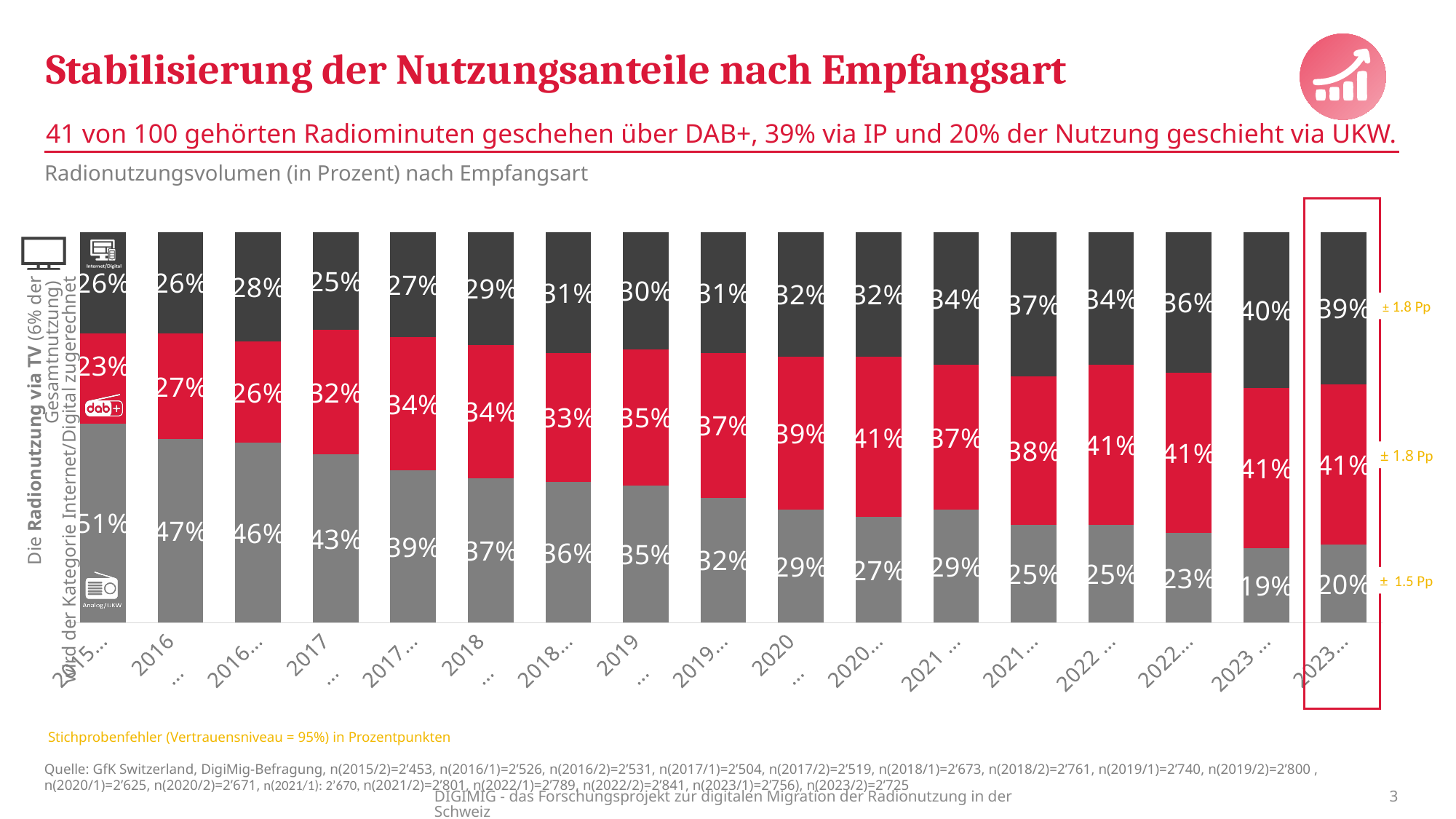
In the last, highlighted bar (2023), what percentage is shown for the dark top segment (Internet/Digital)? 39% In the last, highlighted bar, which segment is larger: the red DAB+ segment or the dark Internet/Digital segment? The red DAB+ segment (41%) How many bars (survey waves) are plotted in the chart? 17 What is the lowest value shown for the grey bottom segment (Analog/UKW) across all bars? 19% In the first bar (2015), what percentage is shown for the grey bottom segment (Analog/UKW)? 51% By how many percentage points does the grey segment (Analog/UKW) differ between the first bar (51%) and the last bar (20%)? 31 percentage points In the last, highlighted bar (2023), what percentage is shown for the red middle segment (DAB+)? 41% Does the grey bottom segment (Analog/UKW) rise or fall from the first bar to the last bar? Fall Which bar has the highest value for the grey bottom segment (Analog/UKW)? The first bar (2015), 51% What sampling error is shown next to the red DAB+ segment of the last bar? ± 1.8 Pp What type of chart is shown on the slide? Stacked bar chart What is the total of the three segments in the last, highlighted bar (39%, 41%, 20%)? 100%